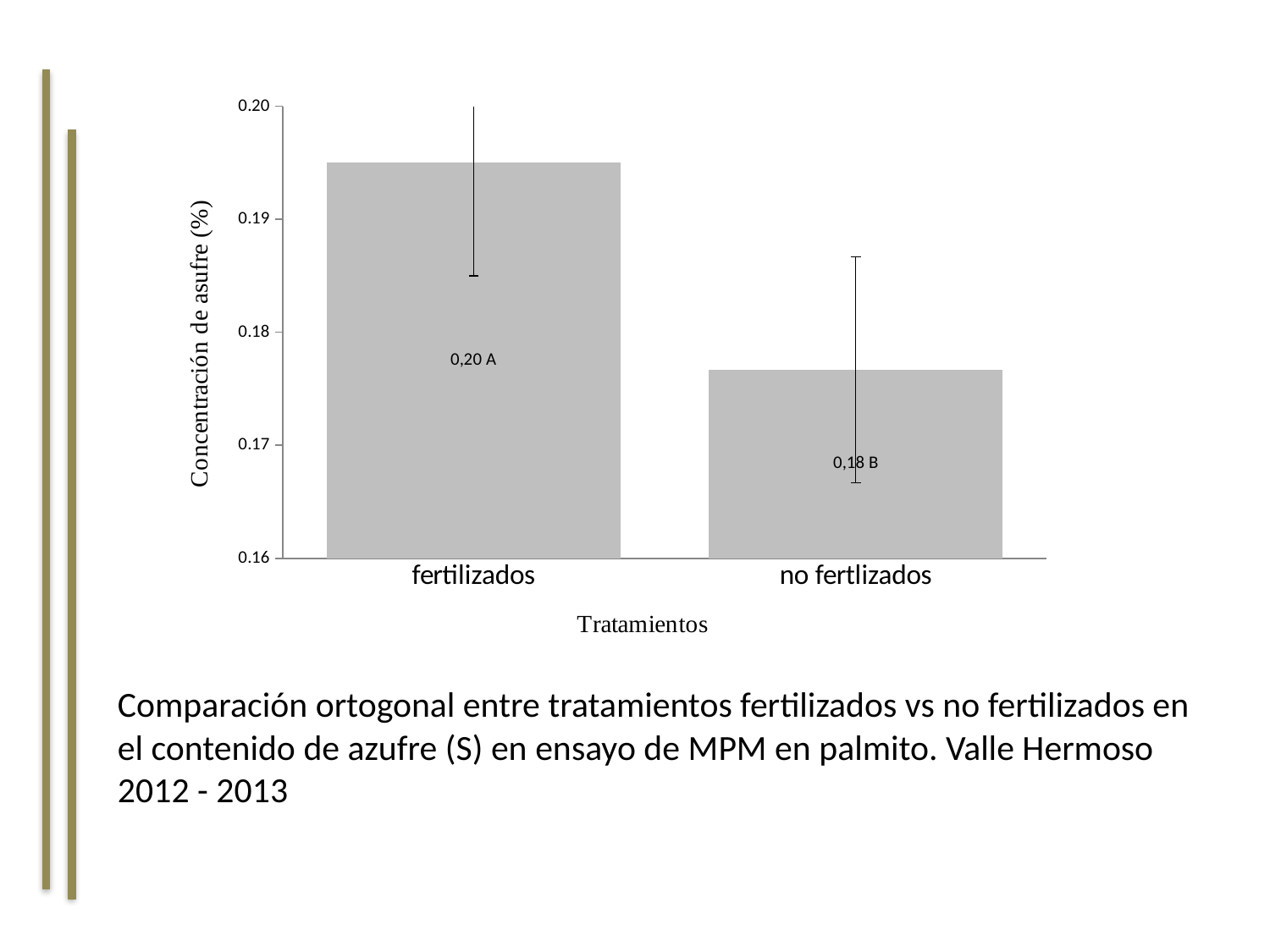
Which treatment has the lowest sulfur concentration? no fertlizados What kind of chart is shown on the slide? bar chart What data label is printed on the fertilizados bar? 0,20 A How many treatment categories are plotted on the x axis? 2 What is the title of the y axis? Concentración de asufre (%) Is the value for no fertlizados greater or less than 0.17? greater Do the bar values rise or fall from fertilizados to no fertlizados? fall Which treatment has the highest sulfur concentration? fertilizados What data label is printed on the no fertlizados bar? 0,18 B Which bar is taller, fertilizados or no fertlizados? fertilizados Is the value for fertilizados greater or less than 0.19? greater